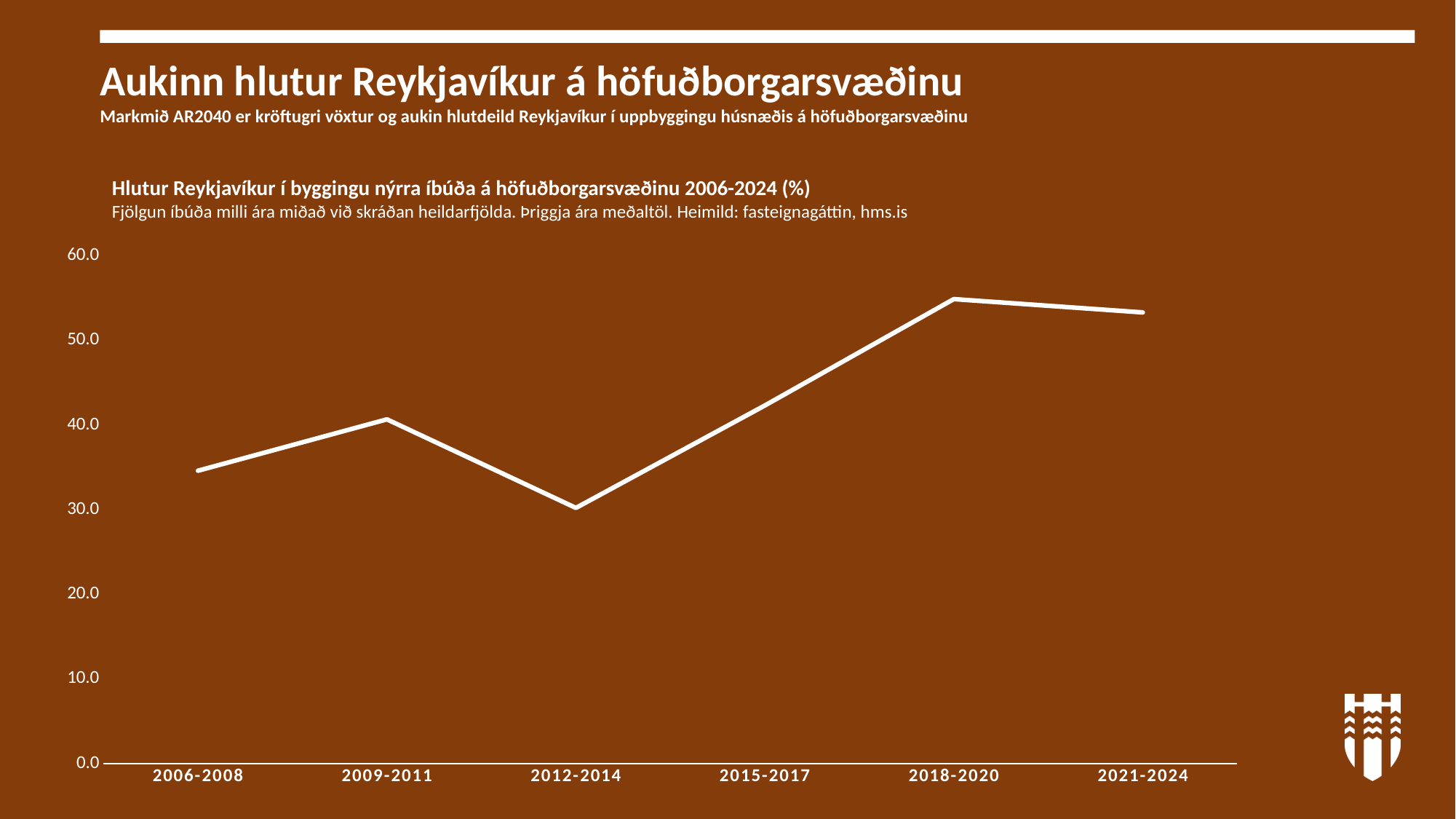
Is the value for 2012-2014 greater or less than 40.0? less What kind of chart is shown on the slide? line chart What is the title of the chart? Hlutur Reykjavíkur í byggingu nýrra íbúða á höfuðborgarsvæðinu 2006-2024 (%) Is the value for 2006-2008 greater or less than 40.0? less Which is larger, the value for 2009-2011 or the value for 2006-2008? 2009-2011 Which period has the lowest share of Reykjavík in new housing construction? 2012-2014 Which is larger, the value for 2015-2017 or the value for 2012-2014? 2015-2017 Is the value for 2015-2017 greater or less than 50.0? less Which period has the highest share of Reykjavík in new housing construction? 2018-2020 How many periods are shown on the x axis of the chart? 6